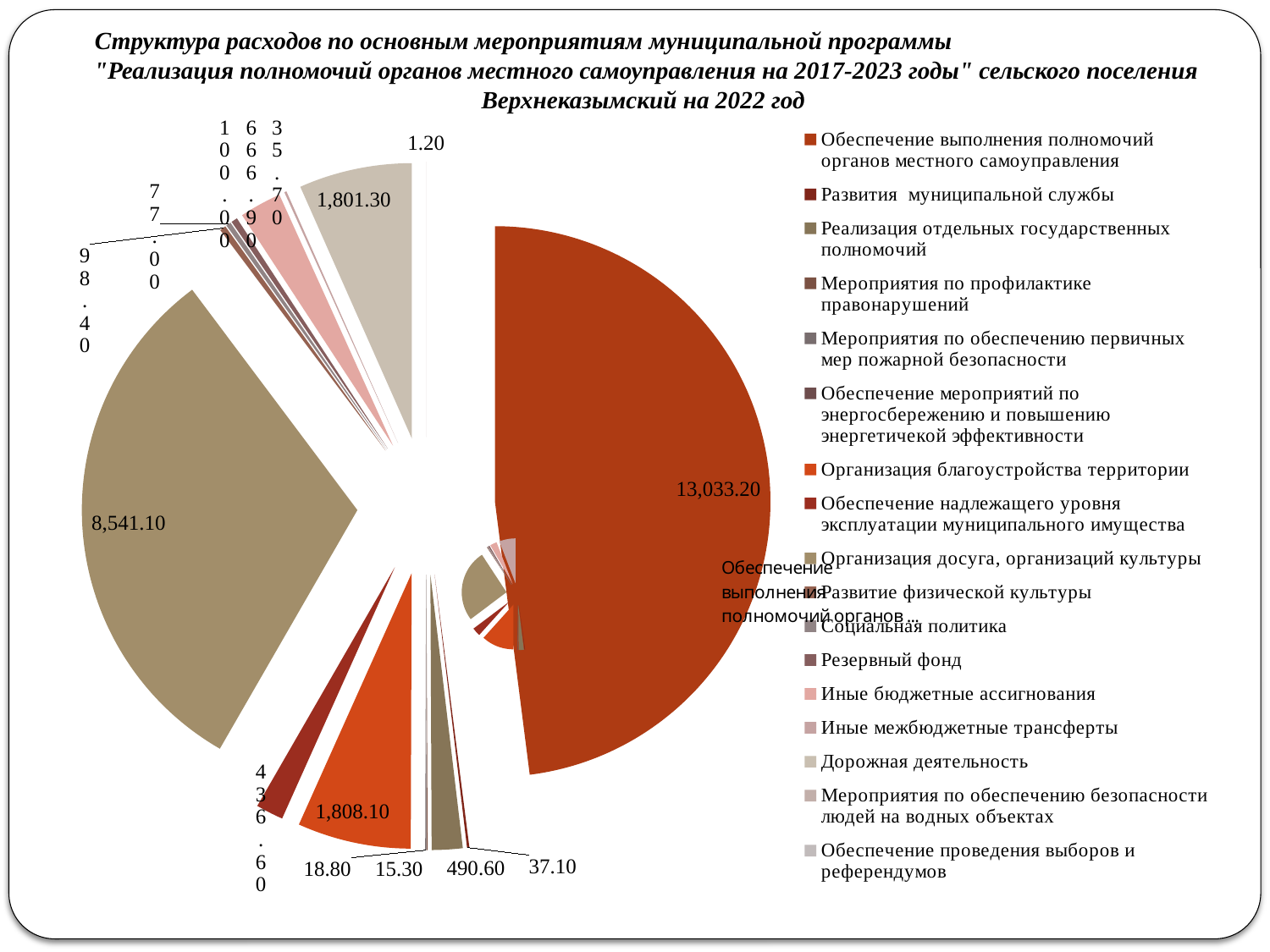
What is the difference between the values for Организация благоустройства территории and Дорожная деятельность? 6.80 Which is larger: the value for Организация благоустройства территории or the value for Дорожная деятельность? Организация благоустройства территории What kind of chart is shown on the slide? Pie chart What is the value shown for Организация благоустройства территории? 1,808.10 What is the value of the largest slice of the pie chart? 13,033.20 Which category has the largest slice in the pie chart? Обеспечение выполнения полномочий органов местного самоуправления What is the value shown for Реализация отдельных государственных полномочий? 490.60 What is the value of the smallest slice of the pie chart? 1.20 What is the value shown for Дорожная деятельность? 1,801.30 What is the difference between the values for Обеспечение выполнения полномочий органов местного самоуправления and Организация досуга, организаций культуры? 4,492.10 What is the value shown for Организация досуга, организаций культуры? 8,541.10 How many categories does the legend of the pie chart list? 17